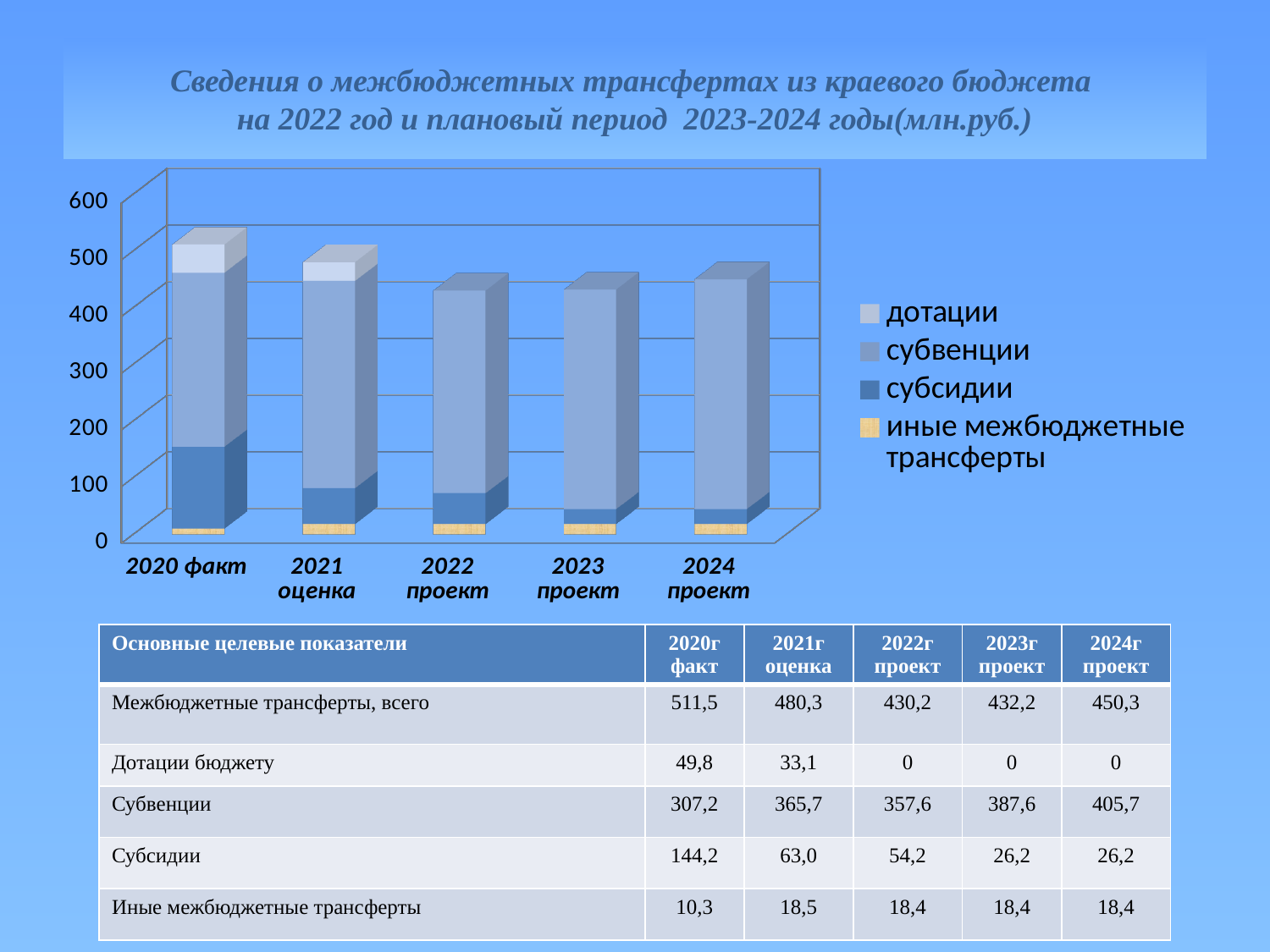
Does the total bar height rise or fall from 2020 факт to 2022 проект? falls Which year has the tallest stacked bar in the chart? 2020 факт What is the value of субвенции for 2024 проект? 405,7 How many categories (years) are shown along the x axis of the chart? 5 What kind of chart is shown on the slide? stacked bar chart How many series does the chart legend list? 4 What is the value of дотации for 2022 проект? 0 What is the difference between the total transfers for 2020 факт and 2021 оценка? 31,2 Is the total bar height for 2020 факт greater or less than 500? greater Which series is listed last in the chart legend? иные межбюджетные трансферты Is the total bar height for 2022 проект greater or less than 500? less What is the total of the stacked bar for 2023 проект (Межбюджетные трансферты, всего)? 432,2